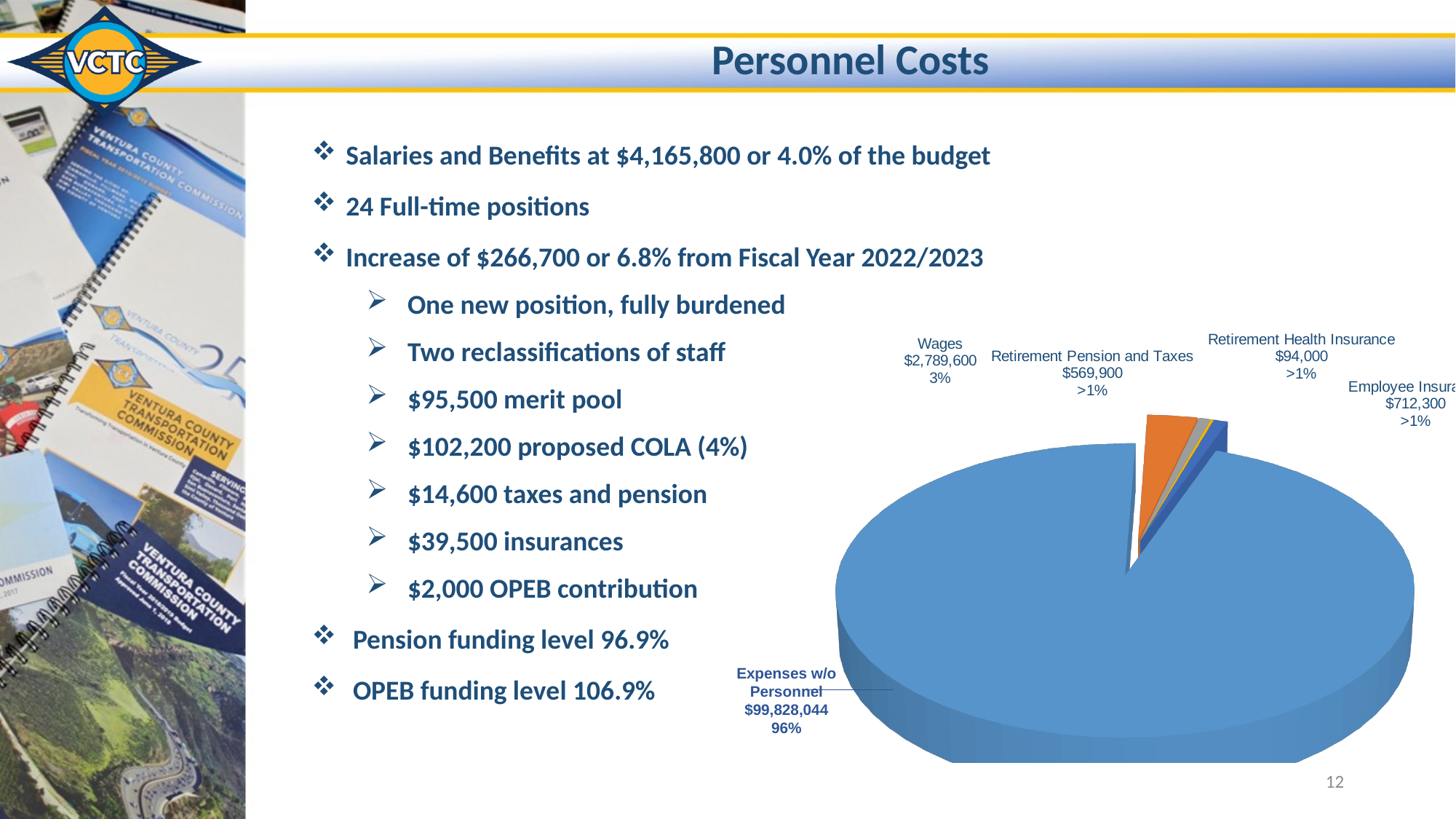
What is the value shown for Retirement Health Insurance in the pie chart? $94,000 What is the value shown for Retirement Pension and Taxes in the pie chart? $569,900 Which slice of the pie chart is the largest? Expenses w/o Personnel How many slices does the pie chart have? 5 What percentage share does the Wages slice have in the pie chart? 3% Which slice of the pie chart has the smallest value? Retirement Health Insurance Which is larger in the pie chart, Wages or Retirement Pension and Taxes? Wages What is the value shown for Expenses w/o Personnel in the pie chart? $99,828,044 What is the difference between the Wages value and the Retirement Pension and Taxes value in the pie chart? $2,219,700 What percentage share does the Expenses w/o Personnel slice have in the pie chart? 96% What is the value shown for Wages in the pie chart? $2,789,600 What kind of chart is shown on the slide? pie chart